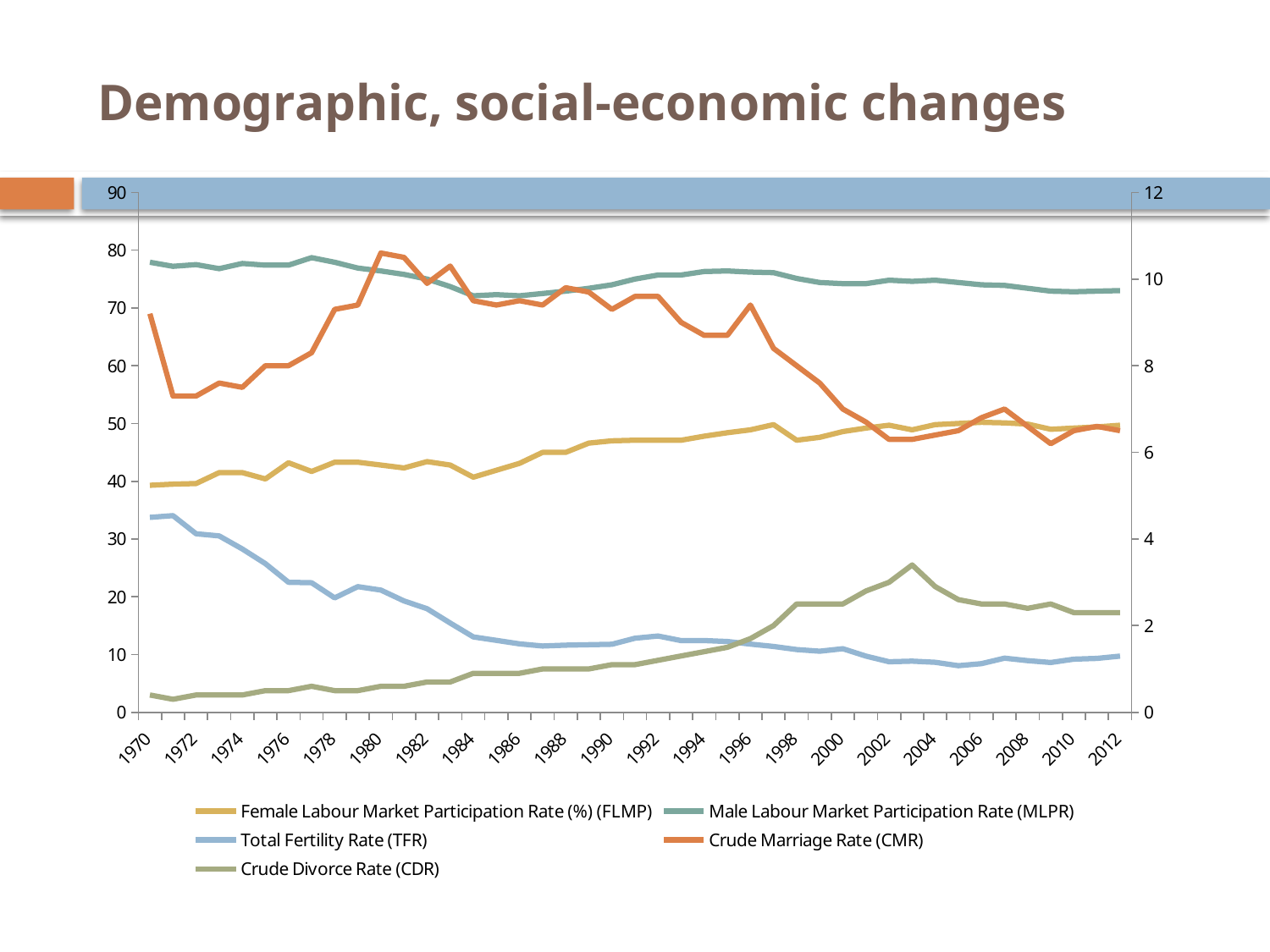
Does the Total Fertility Rate (TFR) rise or fall from 1970 to 2012? fall Does the Male Labour Market Participation Rate (MLPR) rise or fall from 1970 to 2012? fall What kind of chart is shown on the slide? line chart In which year does the Crude Divorce Rate (CDR) reach its highest value? 2003 Does the Female Labour Market Participation Rate (%) (FLMP) rise or fall from 1970 to 2012? rise Is the value for Crude Marriage Rate (CMR) in 1980 greater or less than 10 on the right axis? greater In 2012, which is larger: the Crude Divorce Rate (CDR) or the Total Fertility Rate (TFR)? Crude Divorce Rate (CDR) What is the title of the slide containing the chart? Demographic, social-economic changes Is the value for Male Labour Market Participation Rate (MLPR) in 1970 greater or less than 70 on the left axis? greater How many series does the legend list? 5 Is the value for Total Fertility Rate (TFR) in 2012 greater or less than 2 on the right axis? less Which series is drawn in orange according to the legend? Crude Marriage Rate (CMR)